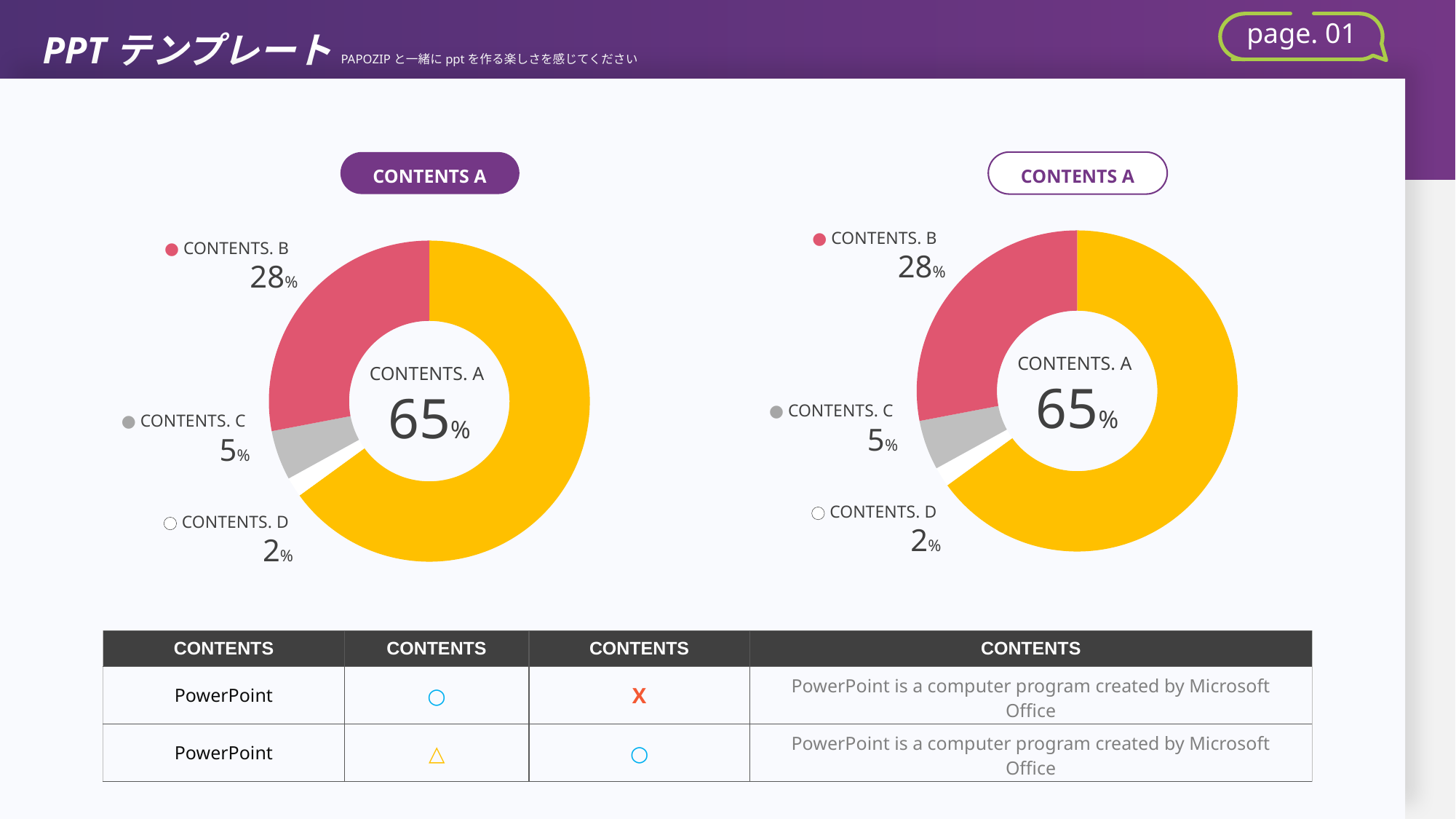
How many categories does the left chart show? 4 On the right chart, which is larger, CONTENTS. B or CONTENTS. C? CONTENTS. B On the right chart, what is the value for CONTENTS. D? 2% What colour is the CONTENTS. A slice on the left chart? Yellow On the left chart, what is the value for CONTENTS. B? 28% On the left chart, what is the value for CONTENTS. A? 65% On the right chart, what is the combined share of CONTENTS. C and CONTENTS. D? 7% What kind of chart is the right chart? Donut (pie) chart On the left chart, what is the difference between the values for CONTENTS. B and CONTENTS. C? 23% On the right chart, what is the value for CONTENTS. C? 5% On the left chart, which category has the largest share? CONTENTS. A On the right chart, which category has the smallest share? CONTENTS. D